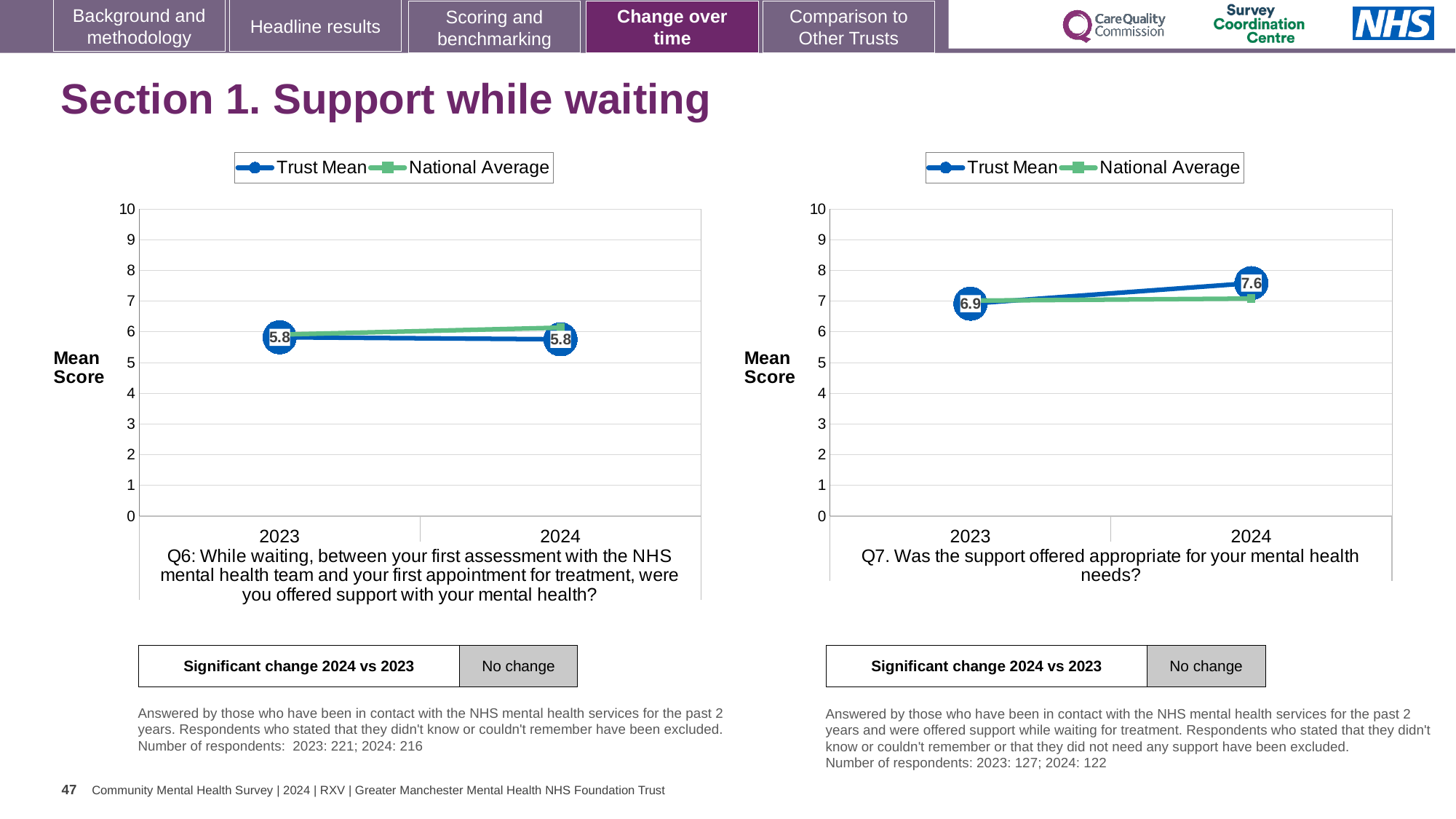
On the left chart (Q6), what is the Trust Mean for 2024? 5.8 How many series does the legend of the right chart (Q7) list? 2 On the right chart (Q7), does the Trust Mean rise or fall from 2023 to 2024? rise On the right chart (Q7), by how much did the Trust Mean change from 2023 to 2024? 0.7 How many years are plotted on the x axis of the left chart (Q6)? 2 On the right chart (Q7), is the Trust Mean for 2024 larger or smaller than the National Average for 2024? larger On the left chart (Q6), is the National Average for 2024 greater or less than 7? less What kind of chart is used on the left (Q6)? line chart On the left chart (Q6), what is the Trust Mean for 2023? 5.8 On the right chart (Q7), what is the Trust Mean for 2023? 6.9 On the right chart (Q7), in which year is the Trust Mean highest? 2024 On the right chart (Q7), what is the Trust Mean for 2024? 7.6